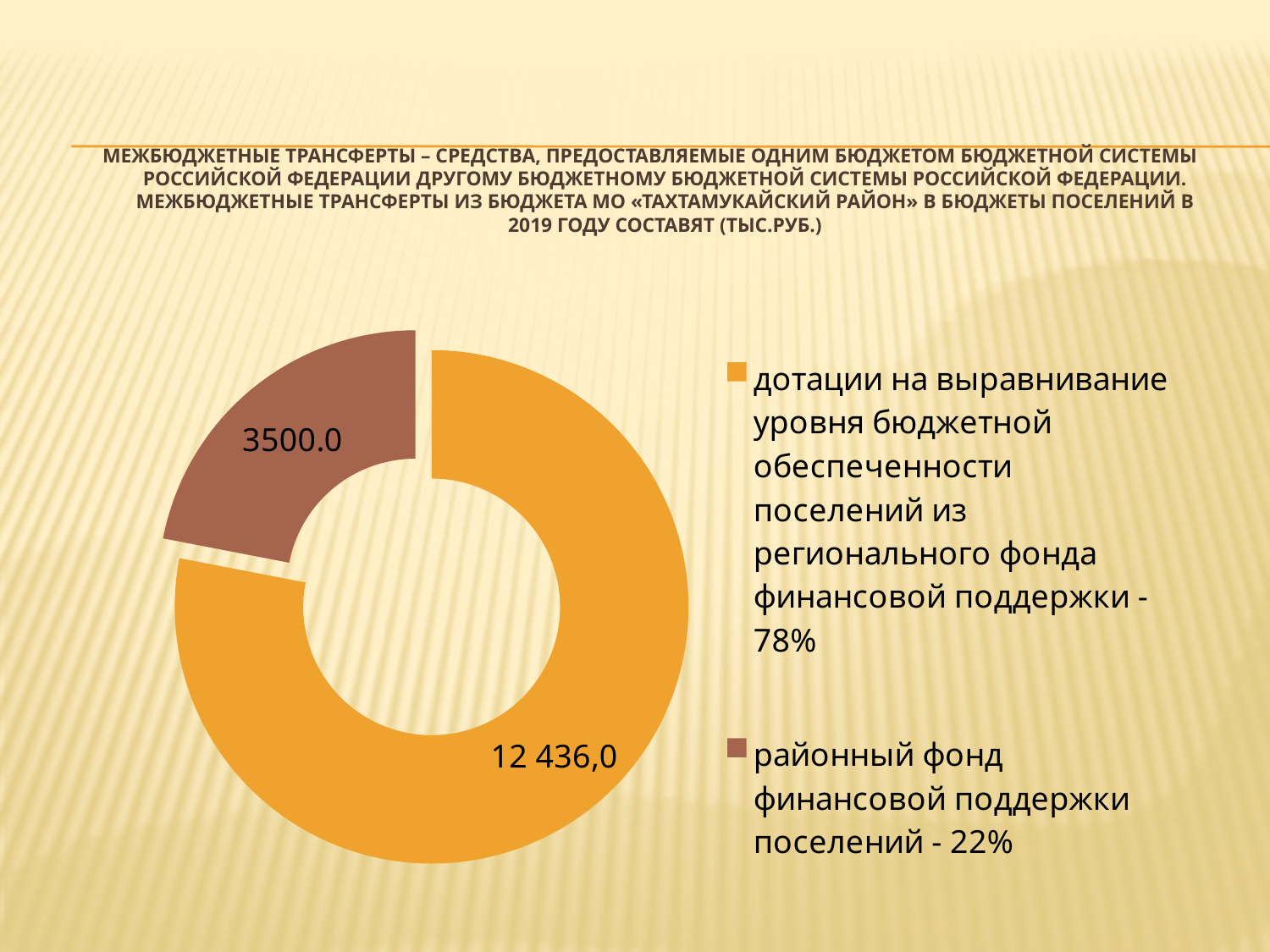
Which category has the largest slice? дотации на выравнивание уровня бюджетной обеспеченности поселений из регионального фонда финансовой поддержки What share of the total does «дотации на выравнивание уровня бюджетной обеспеченности поселений» account for, according to the legend? 78% What is the value for «дотации на выравнивание уровня бюджетной обеспеченности поселений из регионального фонда финансовой поддержки»? 12 436,0 What colour is the slice for «районный фонд финансовой поддержки поселений»? Brown How many entries does the legend list? 2 How many slices does the chart have? 2 What kind of chart is shown on the slide? Doughnut (pie) chart Which is larger: the value for «дотации на выравнивание» or the value for «районный фонд финансовой поддержки поселений»? дотации на выравнивание Which category has the smallest slice? районный фонд финансовой поддержки поселений What share of the total does «районный фонд финансовой поддержки поселений» account for, according to the legend? 22% What is the value for «районный фонд финансовой поддержки поселений»? 3500.0 What is the difference between the value for «дотации на выравнивание» (12 436,0) and the value for «районный фонд финансовой поддержки поселений» (3500.0)? 8936